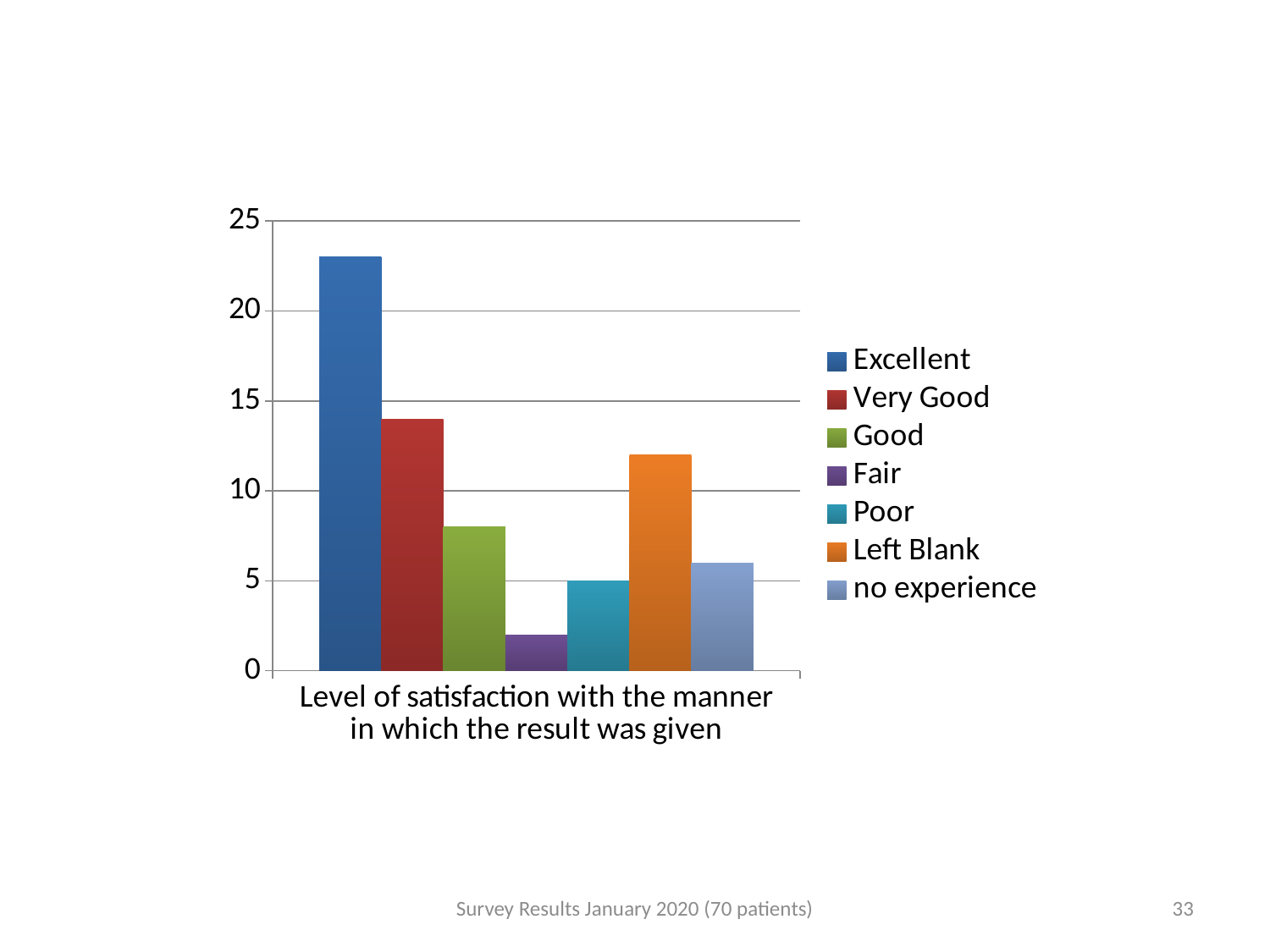
Is the value for Excellent greater or less than 20? greater Which is larger, the value for Good or the value for no experience? Good What is the category label shown beneath the bars on the x axis? Level of satisfaction with the manner in which the result was given What kind of chart is shown on the slide? bar chart Which is larger, the value for Very Good or the value for Left Blank? Very Good Is the value for Very Good greater or less than 15? less Is the value for Good greater or less than 10? less Which series has the highest value? Excellent How many series does the legend list? 7 Which series has the lowest value? Fair